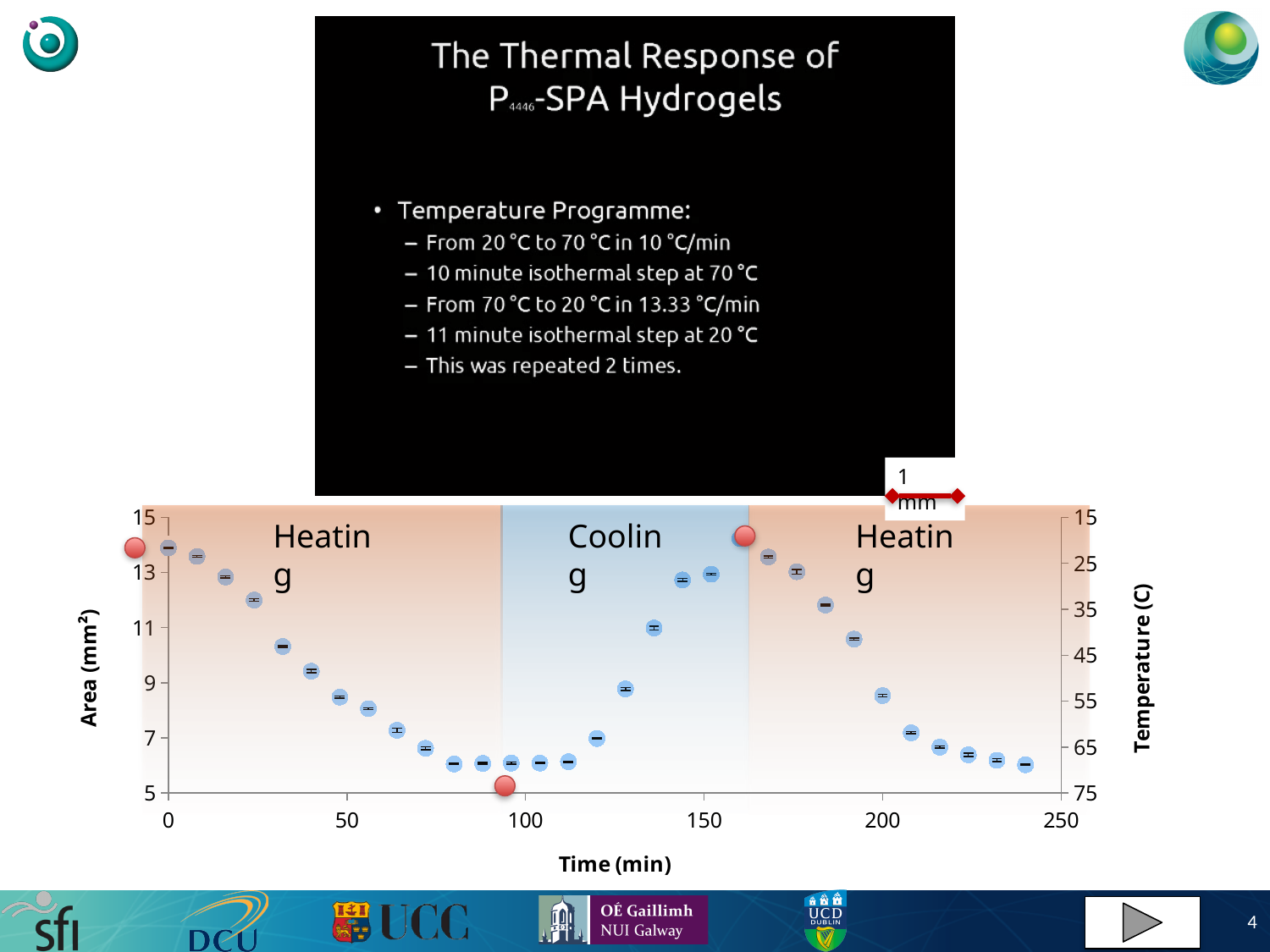
Is the area value at about 150 min greater or less than 11? greater Is the area value at time 0 min greater or less than 13? greater What kind of chart is shown at the bottom of the slide? scatter chart Which is larger, the area at time 0 min or the area at about 80 min? time 0 min Does the area rise or fall as time goes from about 100 to 160 min? rise Is the area value at about 240 min greater or less than 7? less Does the area rise or fall as time goes from about 170 to 240 min? fall What is the title of the left y axis of the chart? Area (mm²) What is the title of the x axis of the chart? Time (min) Which is larger, the area at about 120 min or the area at about 150 min? about 150 min Does the area rise or fall as time goes from 0 to about 90 min? fall